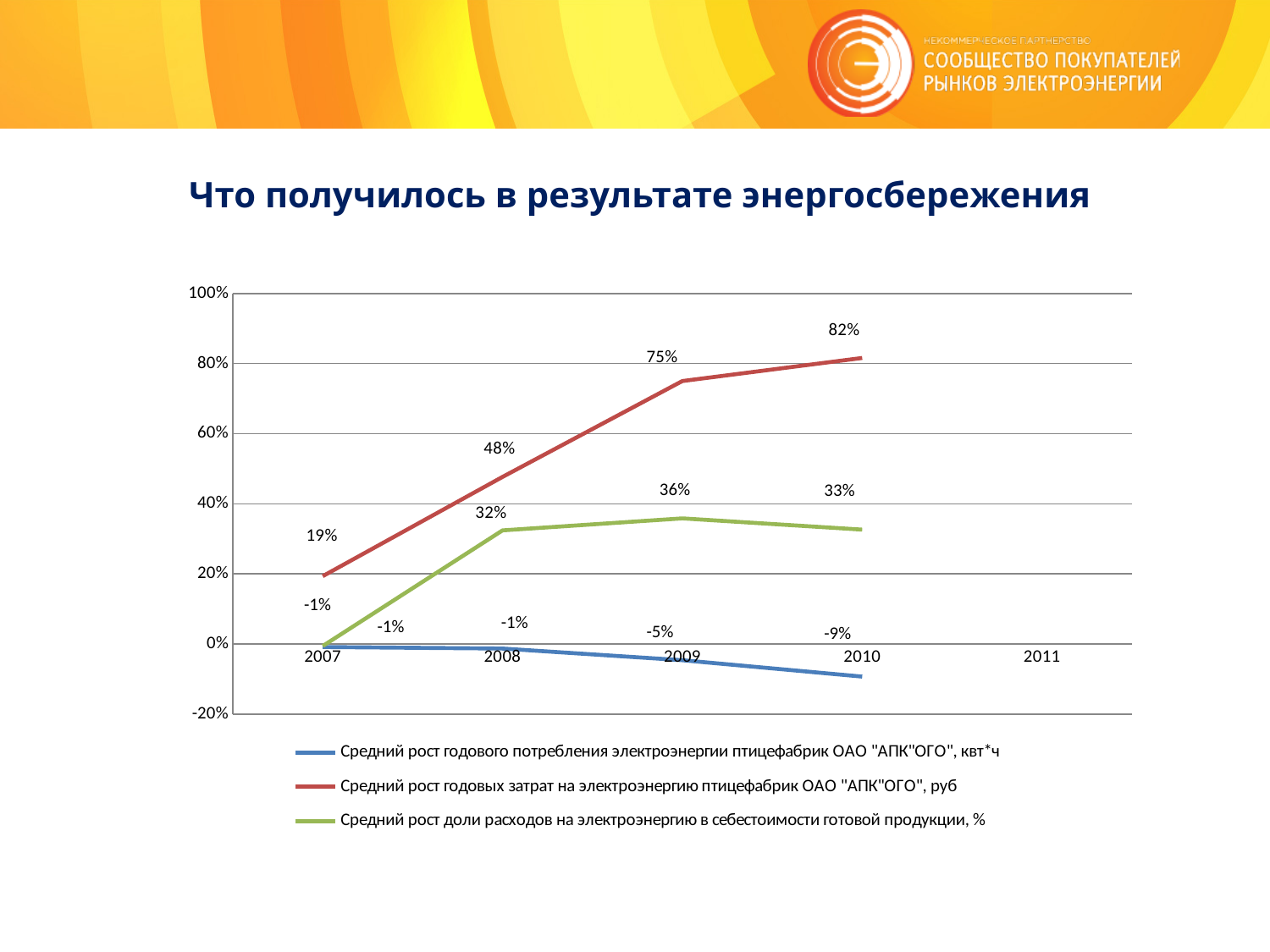
What colour is the line for the series "Средний рост годовых затрат на электроэнергию птицефабрик ОАО "АПК"ОГО", руб"? red Is the 2009 value of the series "Средний рост годовых затрат на электроэнергию птицефабрик ОАО "АПК"ОГО", руб" greater or less than 60%? greater Does the series "Средний рост годового потребления электроэнергии птицефабрик ОАО "АПК"ОГО", квт*ч" rise or fall from 2007 to 2010? fall How many series does the legend list? 3 What is the value for 2010 in the series "Средний рост годовых затрат на электроэнергию птицефабрик ОАО "АПК"ОГО", руб"? 82% What is the value for 2010 in the series "Средний рост годового потребления электроэнергии птицефабрик ОАО "АПК"ОГО", квт*ч"? -9% For the series "Средний рост доли расходов на электроэнергию в себестоимости готовой продукции, %", which year has the larger value, 2008 or 2010? 2010 What is the value for 2008 in the series "Средний рост годовых затрат на электроэнергию птицефабрик ОАО "АПК"ОГО", руб"? 48% What kind of chart is shown on the slide? line chart What is the value for 2009 in the series "Средний рост доли расходов на электроэнергию в себестоимости готовой продукции, %"? 36% By how many percentage points did the series "Средний рост годовых затрат на электроэнергию птицефабрик ОАО "АПК"ОГО", руб" increase from 2007 to 2010? 63 percentage points In which year does the series "Средний рост годовых затрат на электроэнергию птицефабрик ОАО "АПК"ОГО", руб" reach its highest value? 2010